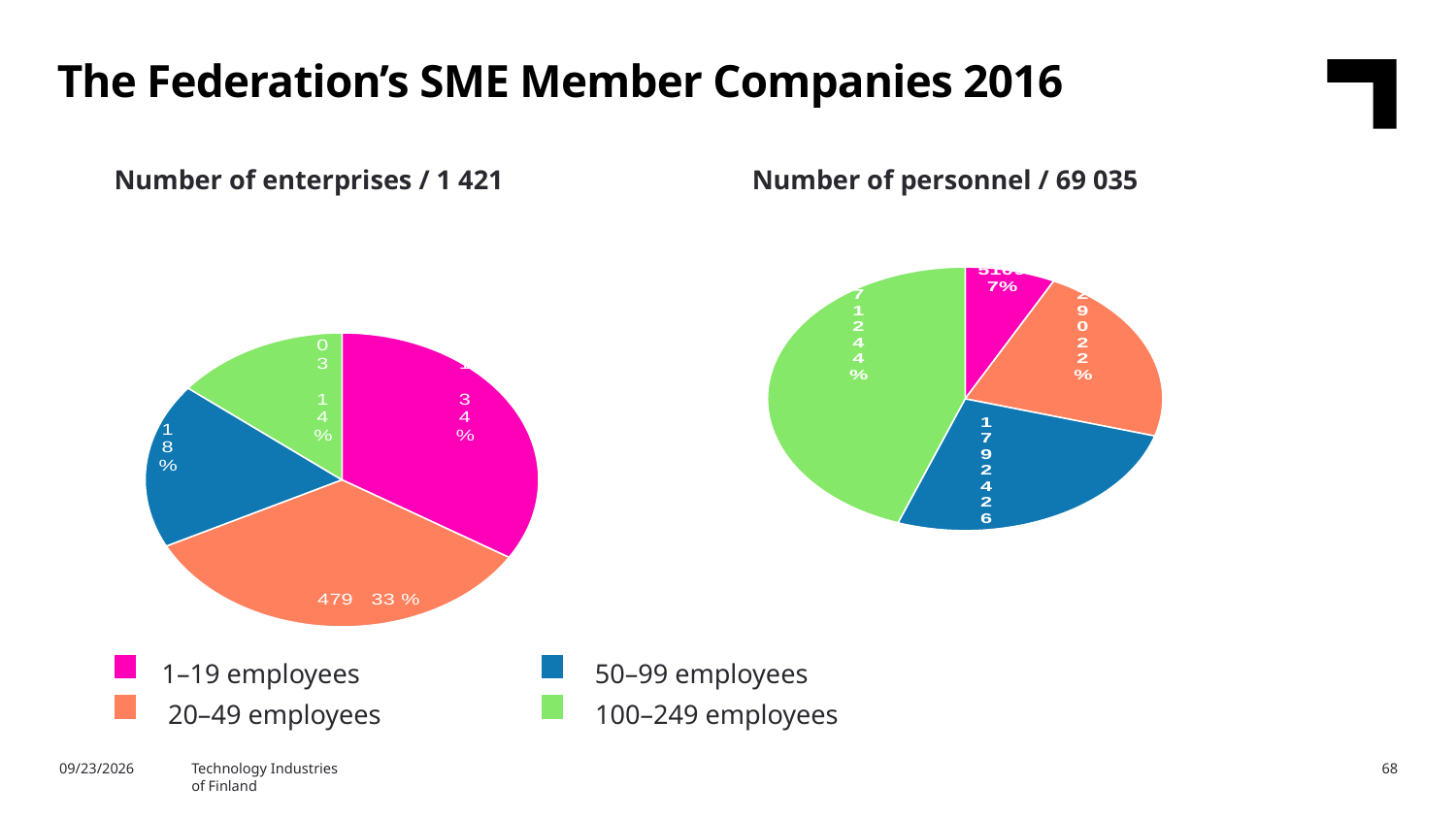
In the 'Number of enterprises / 1 421' chart, what share do companies with 100–249 employees have? 14 % In the 'Number of personnel / 69 035' chart, what share do companies with 100–249 employees have? 44% In the 'Number of personnel / 69 035' chart, which category has the largest slice? 100–249 employees How many employee-size categories does the legend list? 4 In the 'Number of enterprises / 1 421' chart, what share do companies with 1–19 employees have? 34 % In the 'Number of enterprises / 1 421' chart, which category has the smallest slice? 100–249 employees In the 'Number of enterprises / 1 421' chart, how many enterprises have 20–49 employees? 479 What kind of charts are shown on the slide? Pie charts Which colour represents companies with 50–99 employees in the legend? Blue In the 'Number of enterprises / 1 421' chart, what share do companies with 20–49 employees have? 33 % In the 'Number of enterprises / 1 421' chart, what share do companies with 50–99 employees have? 18 % In the 'Number of personnel / 69 035' chart, what share do companies with 1–19 employees have? 7%